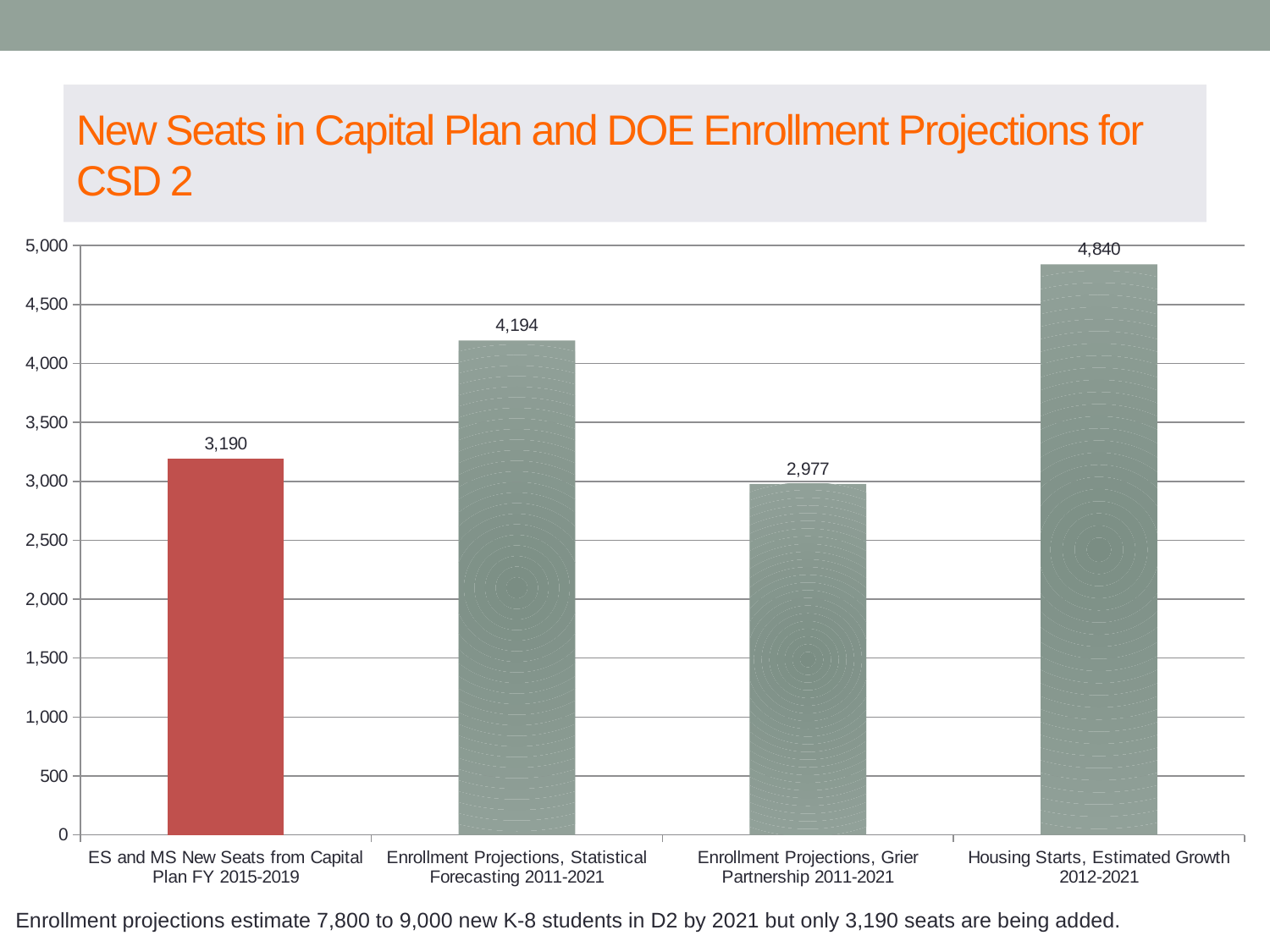
What kind of chart is shown on the slide? Bar chart Which category has the lowest value? Enrollment Projections, Grier Partnership 2011-2021 What is the value for ES and MS New Seats from Capital Plan FY 2015-2019? 3,190 Is the value for Enrollment Projections, Grier Partnership 2011-2021 greater or less than 3,000? less Which is larger: Enrollment Projections, Statistical Forecasting 2011-2021 or Enrollment Projections, Grier Partnership 2011-2021? Enrollment Projections, Statistical Forecasting 2011-2021 What is the value for Housing Starts, Estimated Growth 2012-2021? 4,840 What is the difference between Housing Starts, Estimated Growth 2012-2021 and ES and MS New Seats from Capital Plan FY 2015-2019? 1,650 What is the value for Enrollment Projections, Grier Partnership 2011-2021? 2,977 How many categories are shown in the chart? 4 Which category has the highest value? Housing Starts, Estimated Growth 2012-2021 Which bar is shown in a different colour (red) from the others? ES and MS New Seats from Capital Plan FY 2015-2019 What is the value for Enrollment Projections, Statistical Forecasting 2011-2021? 4,194